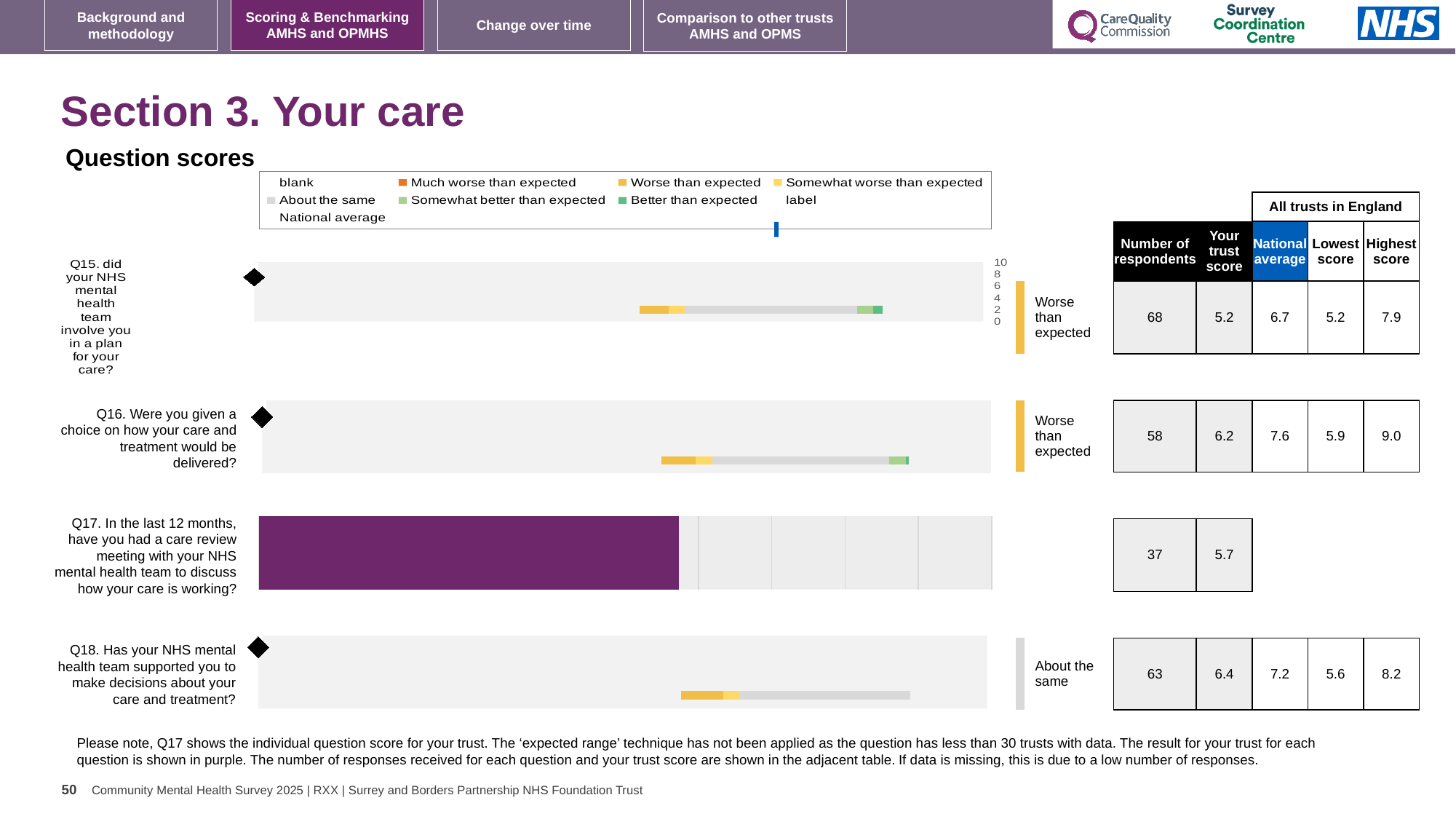
What is the number of respondents for Q15 (did your NHS mental health team involve you in a plan for your care)? 68 How many questions are plotted in the Question scores chart? 4 Which question has the highest trust score? Q18 What is the benchmark label shown for Q18? About the same What is the highest score among all trusts in England for Q16? 9.0 What is the national average for Q18 (has your NHS mental health team supported you to make decisions about your care and treatment)? 7.2 What kind of chart is used to show the question scores? Bar chart What is the trust score for Q16 (were you given a choice on how your care and treatment would be delivered)? 6.2 Which question has the lowest number of respondents? Q17 Which is larger, the trust score for Q15 or the trust score for Q17? Q17 What is the difference between the national average and the trust score for Q16? 1.4 Which question's bar is shown in purple because the expected range technique was not applied? Q17